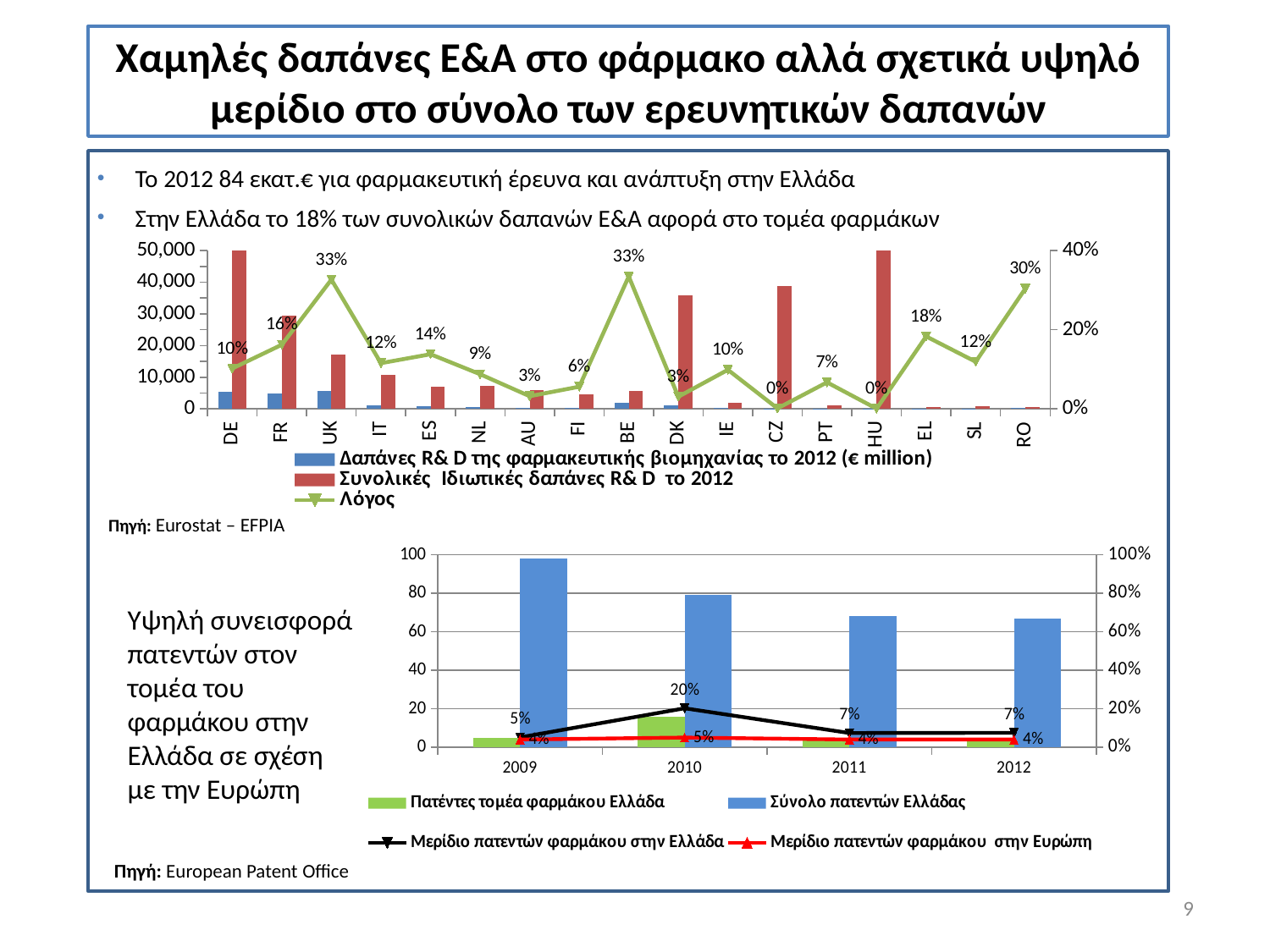
In the top chart, how many series does the legend list? 3 In the top chart, what is the value of the 'Λόγος' (ratio) line for UK? 33% In the top chart, which has a higher ratio value, RO or EL? RO In the bottom chart, what is the difference between the Greek and European shares of pharmaceutical patents in 2010? 15% In the top chart, is the total private R&D expenditure (red bar) for DE greater or less than 40,000? greater In the top chart, what is the ratio value shown for EL? 18% In the bottom chart, in which year is the share of pharmaceutical patents in Greece highest? 2010 In the top chart, what is the difference between the ratio values for UK and DE? 23% In the bottom chart, how many series does the legend list? 4 In the bottom chart, what is the share of pharmaceutical patents in Greece in 2010? 20% In the top chart, how many countries are shown on the x axis? 17 In the bottom chart, is the total number of Greek patents in 2009 greater or less than 80? greater